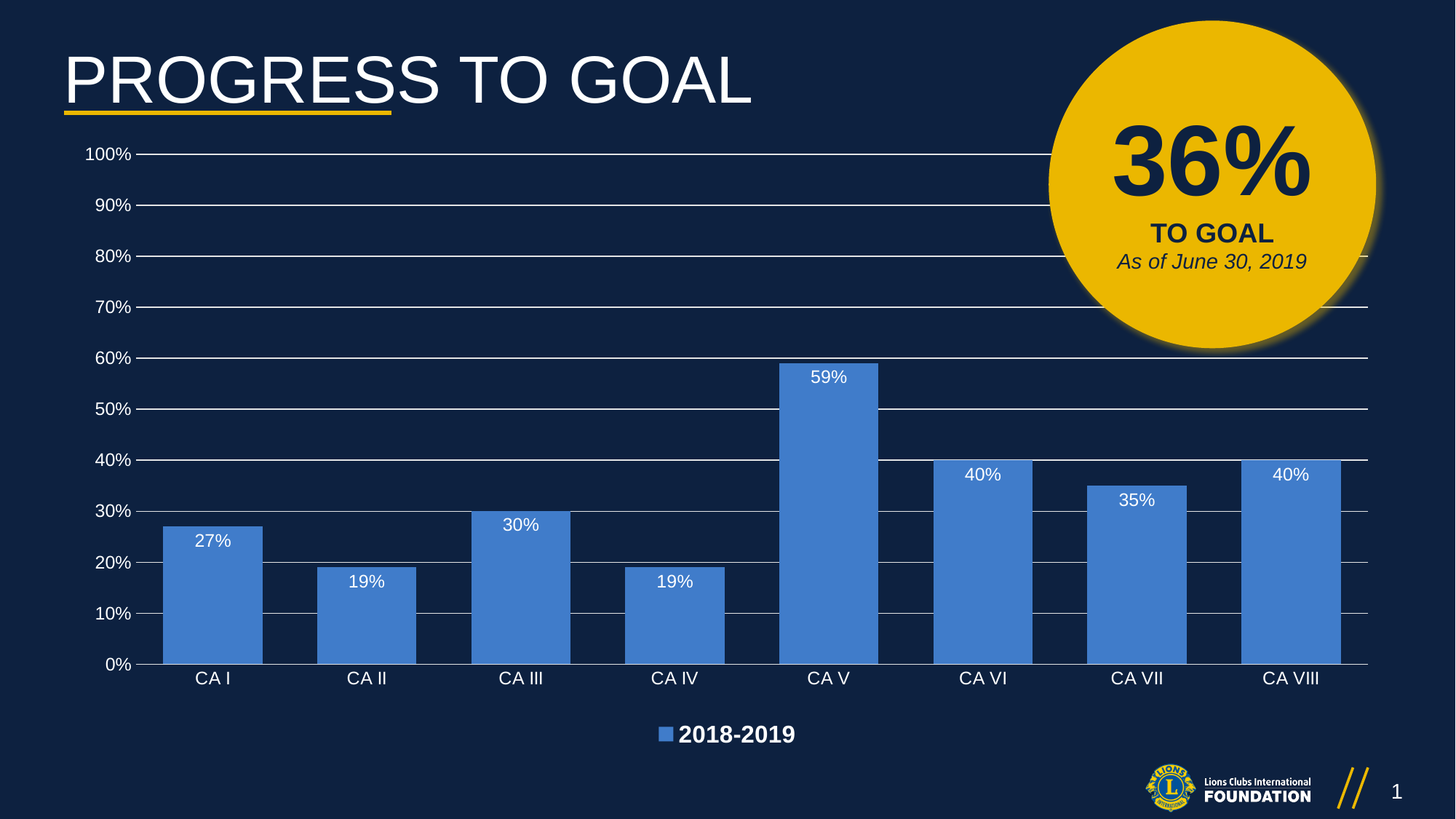
What series name is shown in the legend? 2018-2019 What is the value for CA V? 59% What is the value for CA I? 27% What is the difference between the values for CA V and CA III? 29% How many categories are shown on the x axis? 8 Which category has the highest value? CA V What is the value for CA VII? 35% Is the value for CA V greater or less than 50%? greater What kind of chart is shown on the slide? bar chart What is the difference between the values for CA VI and CA VII? 5% Which is larger, the value for CA I or the value for CA III? CA III How many series does the legend list? 1